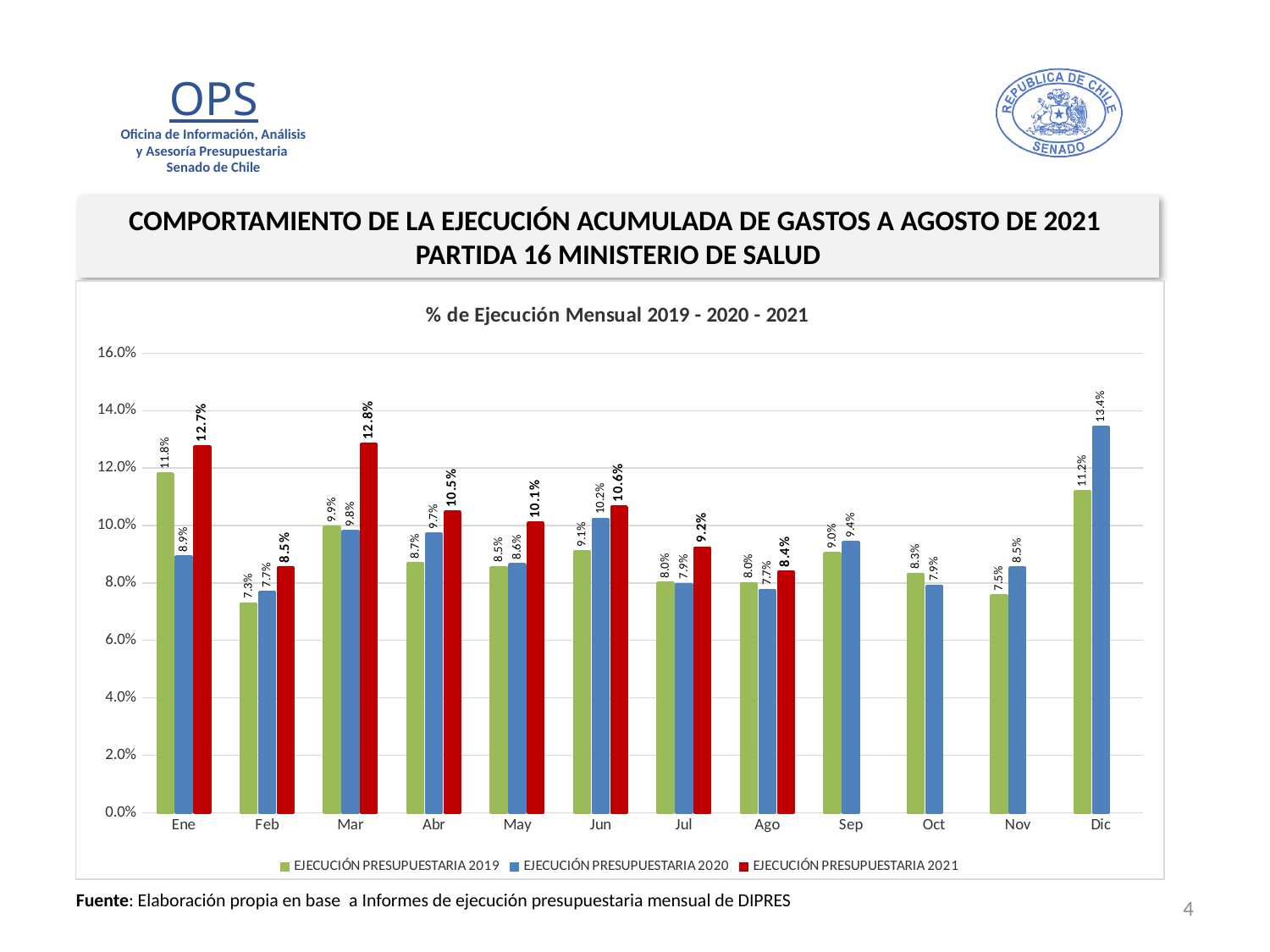
What is the value for EJECUCIÓN PRESUPUESTARIA 2019 in Ene? 11.8% How many months are shown on the x axis? 12 How many series does the legend list? 3 What type of chart is shown on the slide? bar chart What is the difference between the EJECUCIÓN PRESUPUESTARIA 2021 and EJECUCIÓN PRESUPUESTARIA 2019 values in Ene? 0.9% Which is larger in Jun: the EJECUCIÓN PRESUPUESTARIA 2020 value or the EJECUCIÓN PRESUPUESTARIA 2019 value? EJECUCIÓN PRESUPUESTARIA 2020 What is the title of the chart? % de Ejecución Mensual 2019 - 2020 - 2021 Up to which month does the EJECUCIÓN PRESUPUESTARIA 2021 series have data? Ago In which month is the EJECUCIÓN PRESUPUESTARIA 2019 value lowest? Feb What is the value for EJECUCIÓN PRESUPUESTARIA 2020 in Dic? 13.4% What is the value for EJECUCIÓN PRESUPUESTARIA 2021 in Mar? 12.8% In which month is the EJECUCIÓN PRESUPUESTARIA 2021 value highest? Mar